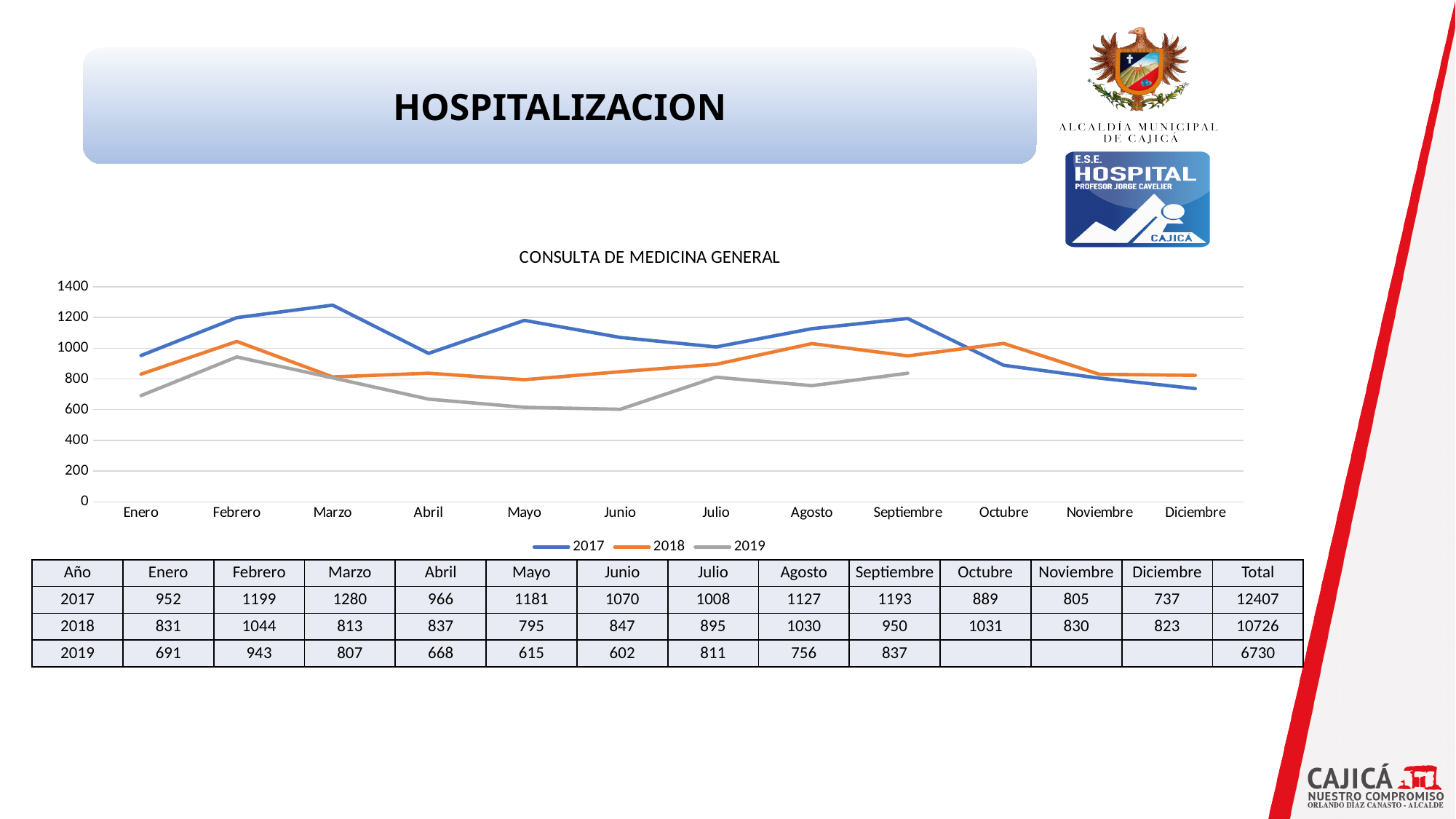
Which series has the larger value in Octubre, 2017 or 2018? 2018 How many series does the legend list? 3 What is the title of the chart? CONSULTA DE MEDICINA GENERAL Does the 2017 series rise or fall from Septiembre to Diciembre? fall What is the difference between the 2017 and 2018 values in Enero? 121 What is the value for 2018 in Octubre? 1031 What type of chart is shown on the slide? line chart In which month does the 2017 series reach its highest value? Marzo In which month does the 2019 series have its lowest value? Junio What is the value for 2019 in Junio? 602 How many months are shown along the x axis? 12 What is the value for 2017 in Marzo? 1280